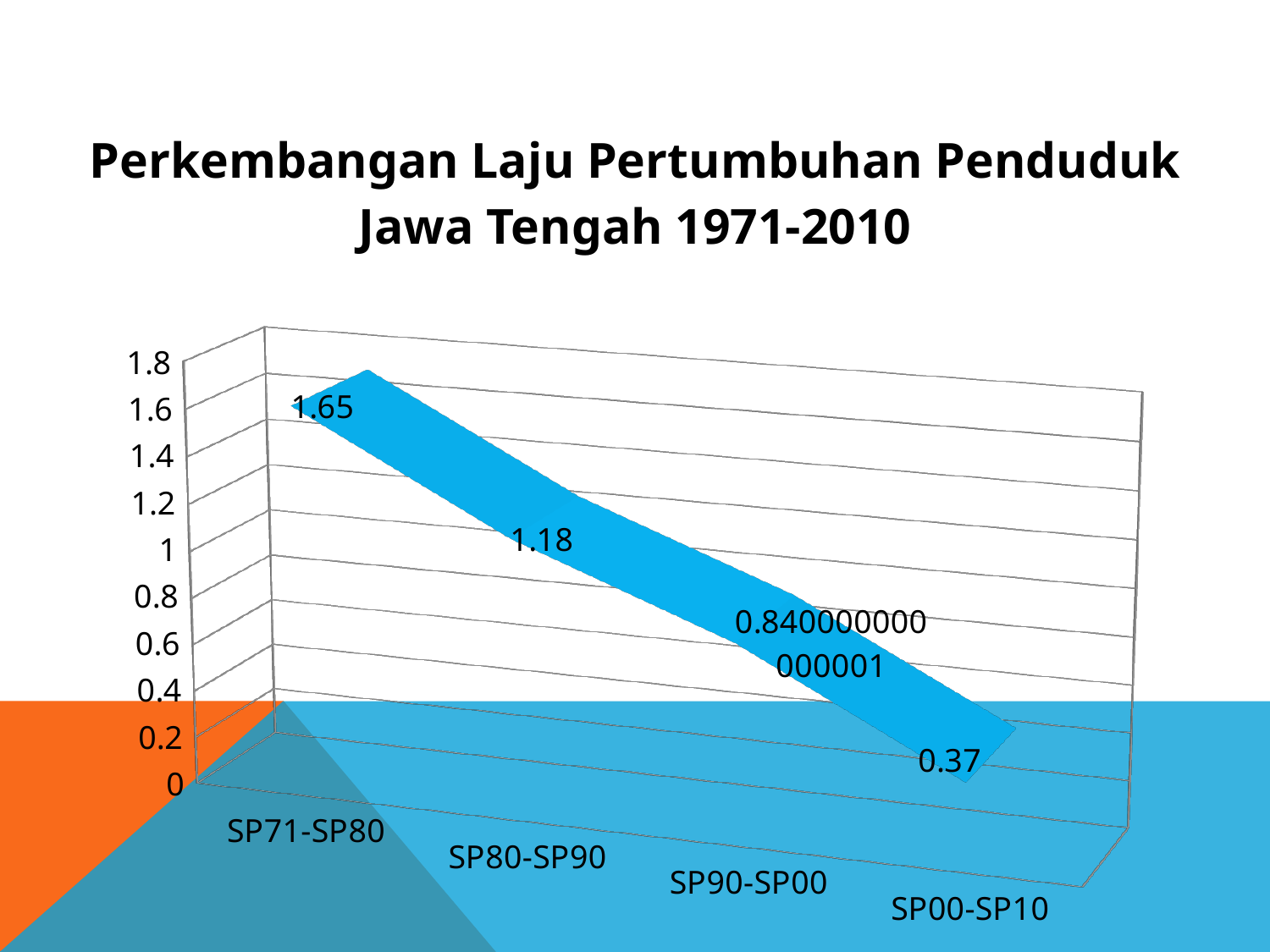
What is the difference between the values for SP71-SP80 and SP00-SP10? 1.28 What is the difference between the values for SP71-SP80 and SP80-SP90? 0.47 Which is larger, the value for SP80-SP90 or the value for SP00-SP10? SP80-SP90 What is the value for SP00-SP10? 0.37 What kind of chart is shown? line chart How many periods are plotted on the chart? 4 What value is printed for SP90-SP00? 0.840000000000001 Which period has the lowest value? SP00-SP10 Which period has the highest value? SP71-SP80 Do the values rise or fall from SP71-SP80 to SP00-SP10? fall What is the value for SP80-SP90? 1.18 What is the value for SP71-SP80? 1.65